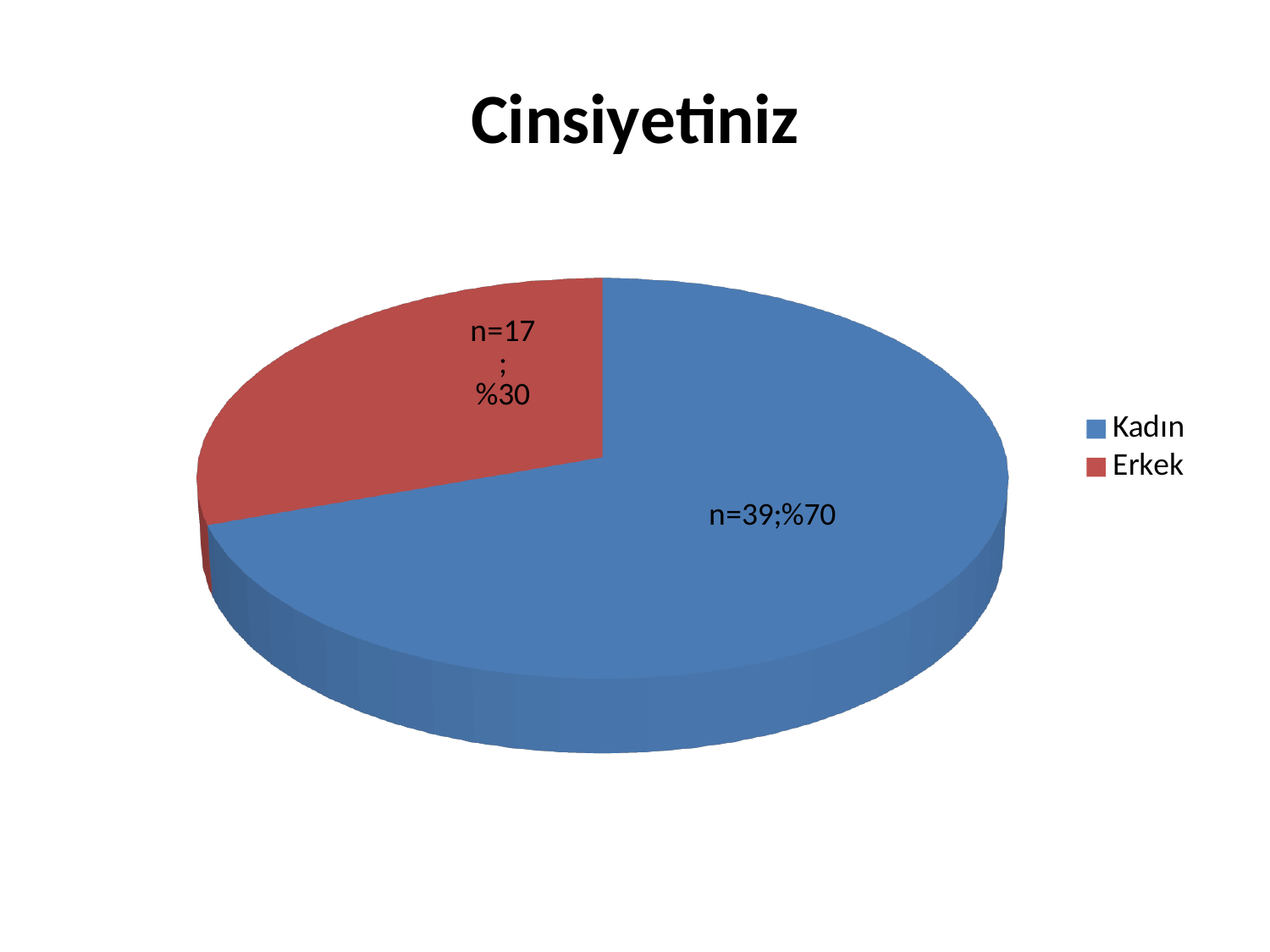
Which category has the largest slice? Kadın What kind of chart is shown on the slide? pie chart What is the title of the chart? Cinsiyetiniz What is the difference in count between Kadın and Erkek? 22 How many entries does the legend list? 2 Which category has the smallest slice? Erkek What share of the pie does Erkek represent? %30 What share of the pie does Kadın represent? %70 What is the count (n) for Erkek? n=17 Which colour represents Erkek in the chart? red What is the count (n) for Kadın? n=39 How many slices does the pie chart have? 2